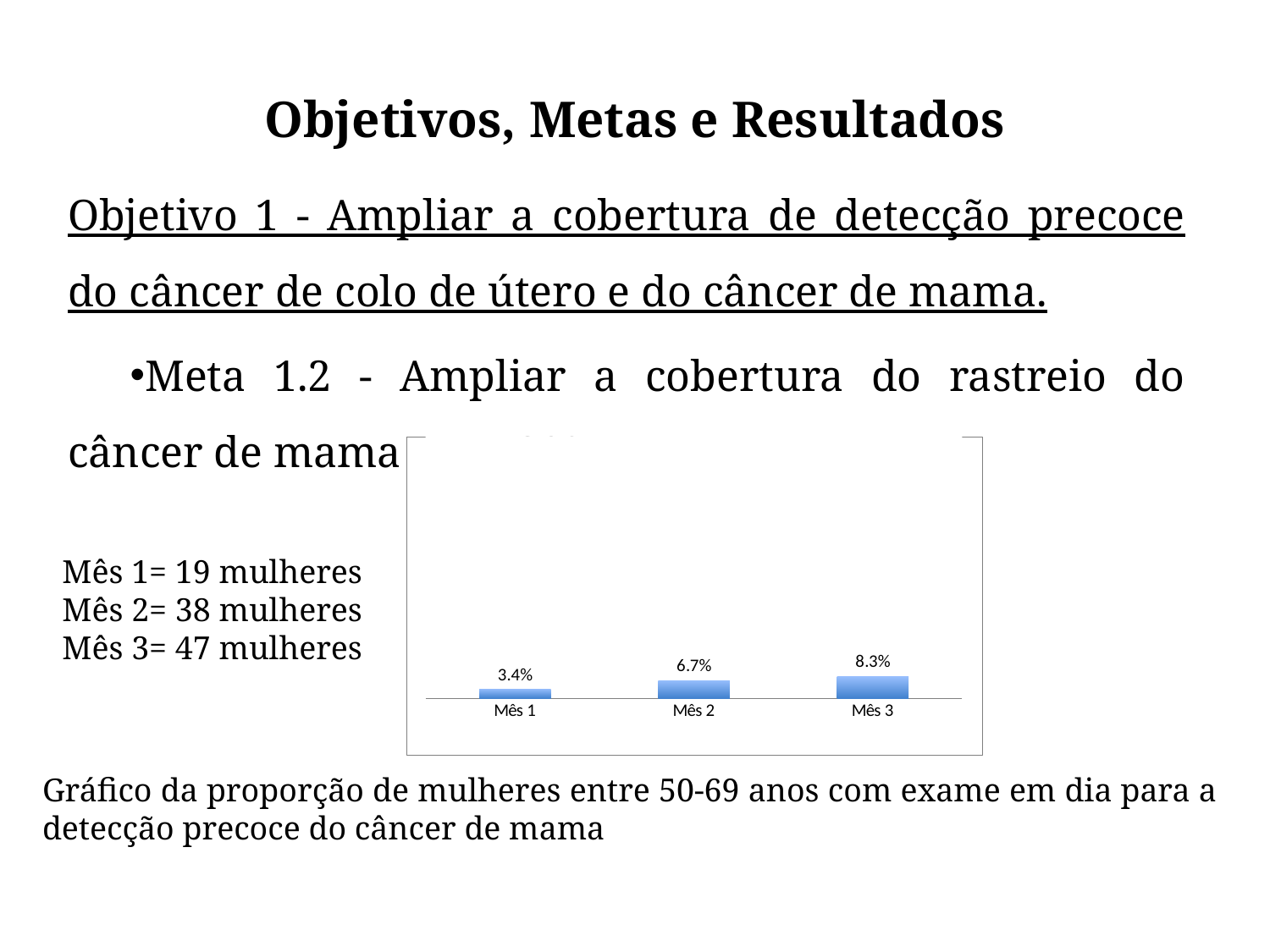
Do the values rise or fall from Mês 1 to Mês 3? Rise Which is larger, the value for Mês 2 or the value for Mês 3? Mês 3 What is the value for Mês 3? 8.3% Which month has the highest value? Mês 3 What is the value for Mês 1? 3.4% What is the difference between the values for Mês 2 and Mês 1? 3.3% What is the difference between the values for Mês 3 and Mês 1? 4.9% What colour are the bars in the chart? Blue How many categories are plotted in the chart? 3 Which month has the lowest value? Mês 1 What is the value for Mês 2? 6.7% What kind of chart is shown on the slide? Bar chart